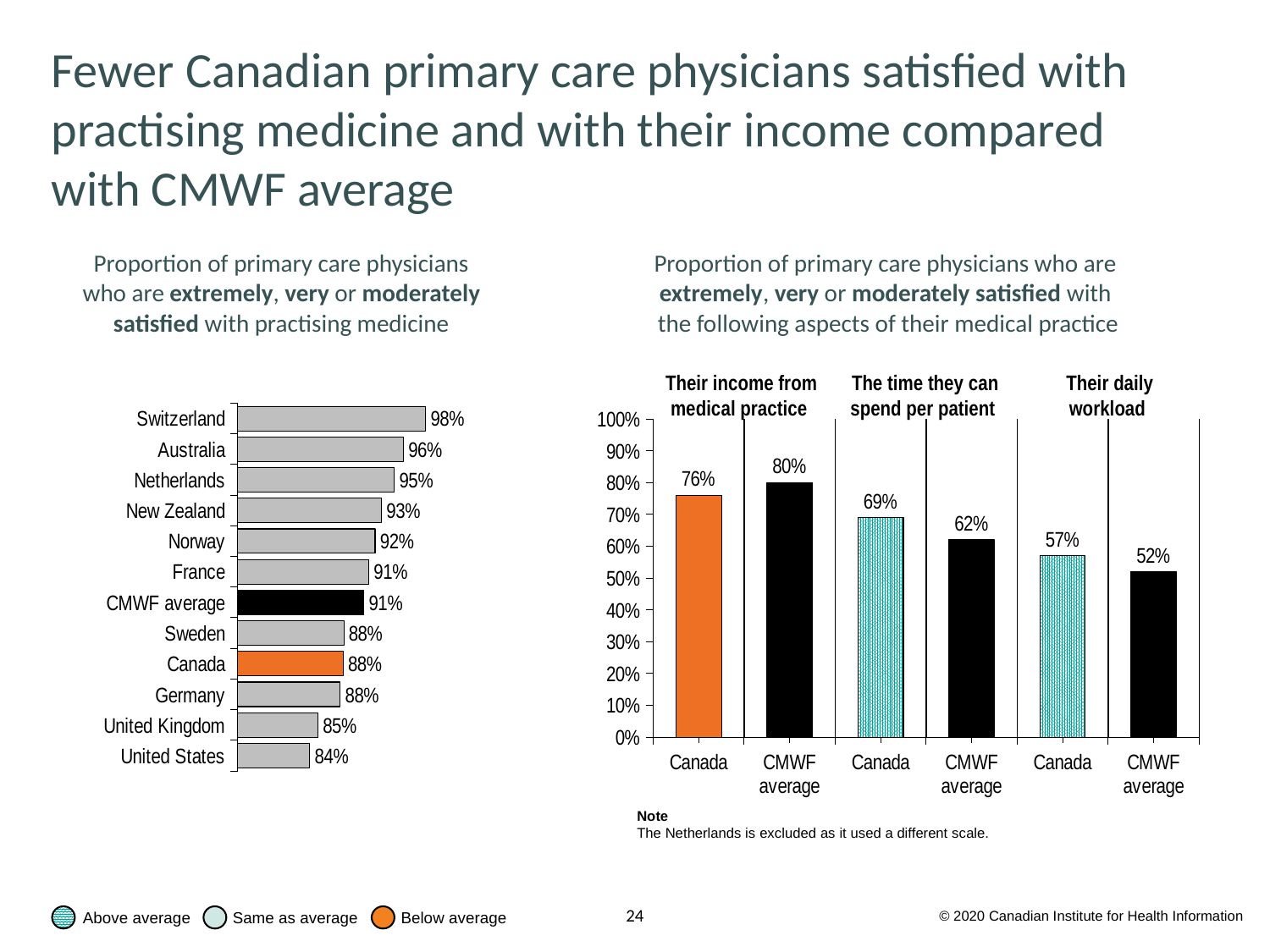
In the left chart on satisfaction with practising medicine, which country has the lowest value? United States In the right chart on aspects of medical practice, what is the value for Canada for their income from medical practice? 76% In the left chart on satisfaction with practising medicine, which country has the highest value? Switzerland In the left chart on satisfaction with practising medicine, how many countries or averages are listed? 12 In the right chart on aspects of medical practice, which is larger for their income from medical practice: Canada or the CMWF average? CMWF average In the left chart on satisfaction with practising medicine, what colour is the bar for Canada? Orange In the right chart on aspects of medical practice, what is the difference between Canada and the CMWF average for the time they can spend per patient? 7% In the left chart on satisfaction with practising medicine, what is the value for Canada? 88% In the left chart on satisfaction with practising medicine, what is the difference between the CMWF average and Canada? 3% In the right chart on aspects of medical practice, what is the CMWF average for their daily workload? 52% What type of chart is the left chart on satisfaction with practising medicine? Bar chart In the left chart on satisfaction with practising medicine, what is the value for Switzerland? 98%